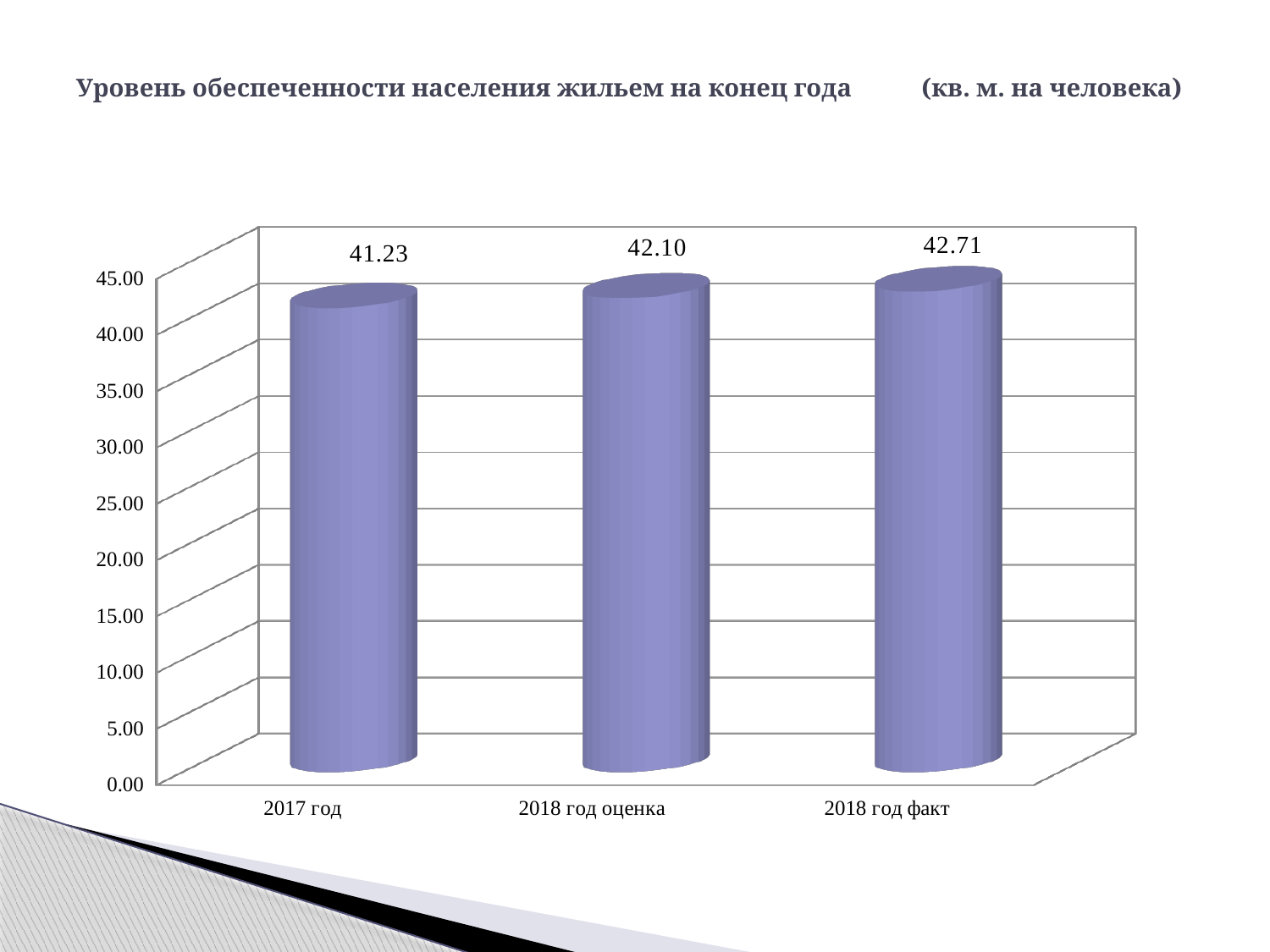
What is the value for 2017 год? 41.23 Is the value for 2017 год greater or less than 40.00? greater Which is larger, the value for 2018 год оценка or the value for 2017 год? 2018 год оценка How many categories are shown on the x axis? 3 What is the value for 2018 год оценка? 42.10 Which category has the highest value? 2018 год факт What kind of chart is shown on the slide? bar chart What is the value for 2018 год факт? 42.71 What is the difference between the values for 2018 год факт and 2017 год? 1.48 Do the values rise or fall from left to right along the x axis? rise What is the difference between the values for 2018 год факт and 2018 год оценка? 0.61 Which category has the lowest value? 2017 год